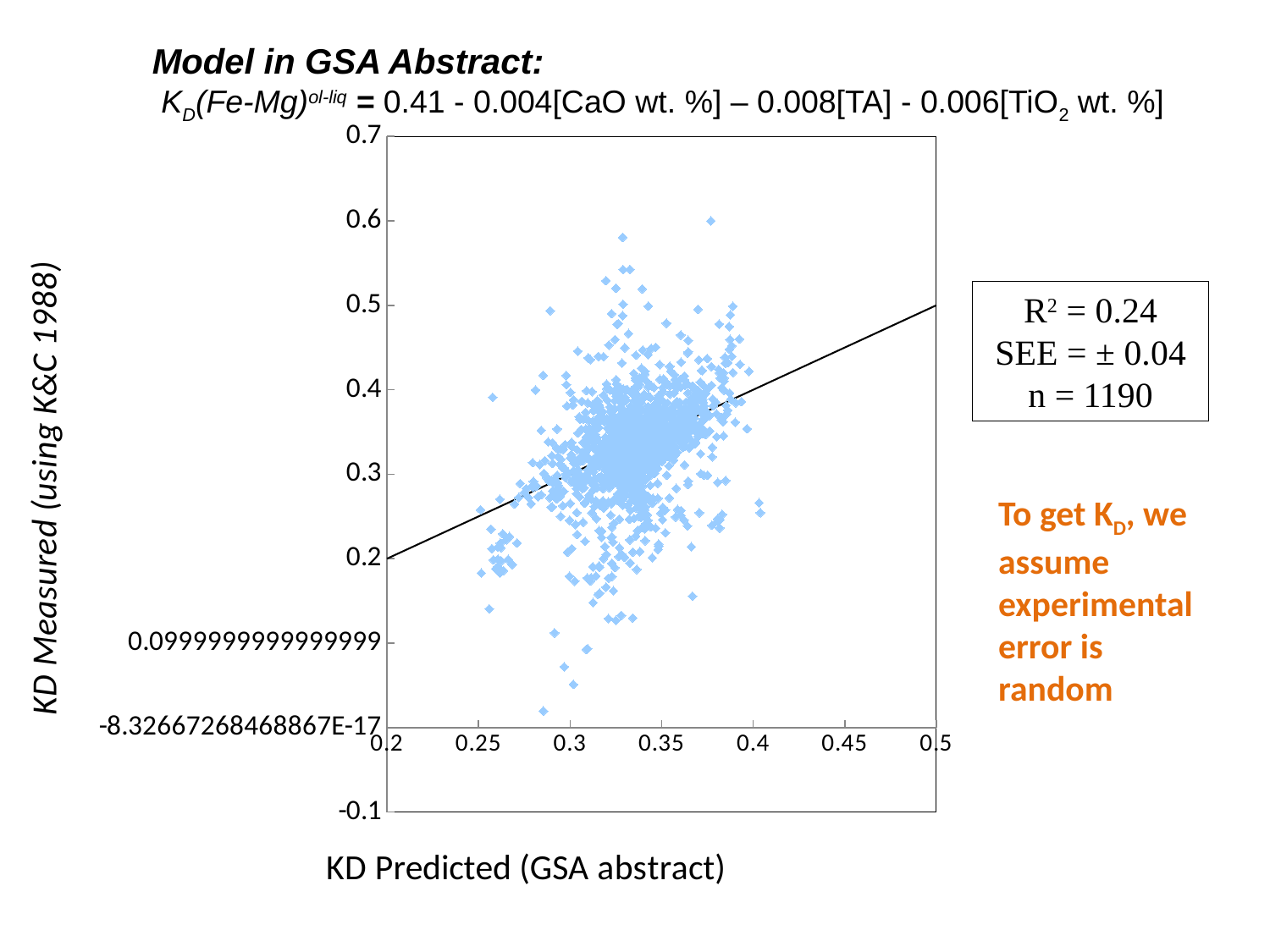
What kind of chart is shown on the slide? scatter chart What is the title of the y axis of the chart? KD Measured (using K&C 1988) Is the lowest KD Measured value among the plotted points greater or less than 0.1? less How many data points (n) does the chart's annotation box say are plotted? 1190 What SEE value is reported in the chart's annotation box? ± 0.04 Is the highest KD Measured value among the plotted points greater or less than 0.5? greater What is the title of the x axis of the chart? KD Predicted (GSA abstract) What is the maximum value shown on the x axis of the chart? 0.5 Is the value of the fitted line at KD Predicted = 0.2 greater or less than 0.3? less What R² value is reported for the fit in the chart's annotation box? 0.24 Do the plotted points generally rise or fall as KD Predicted increases along the x axis? rise